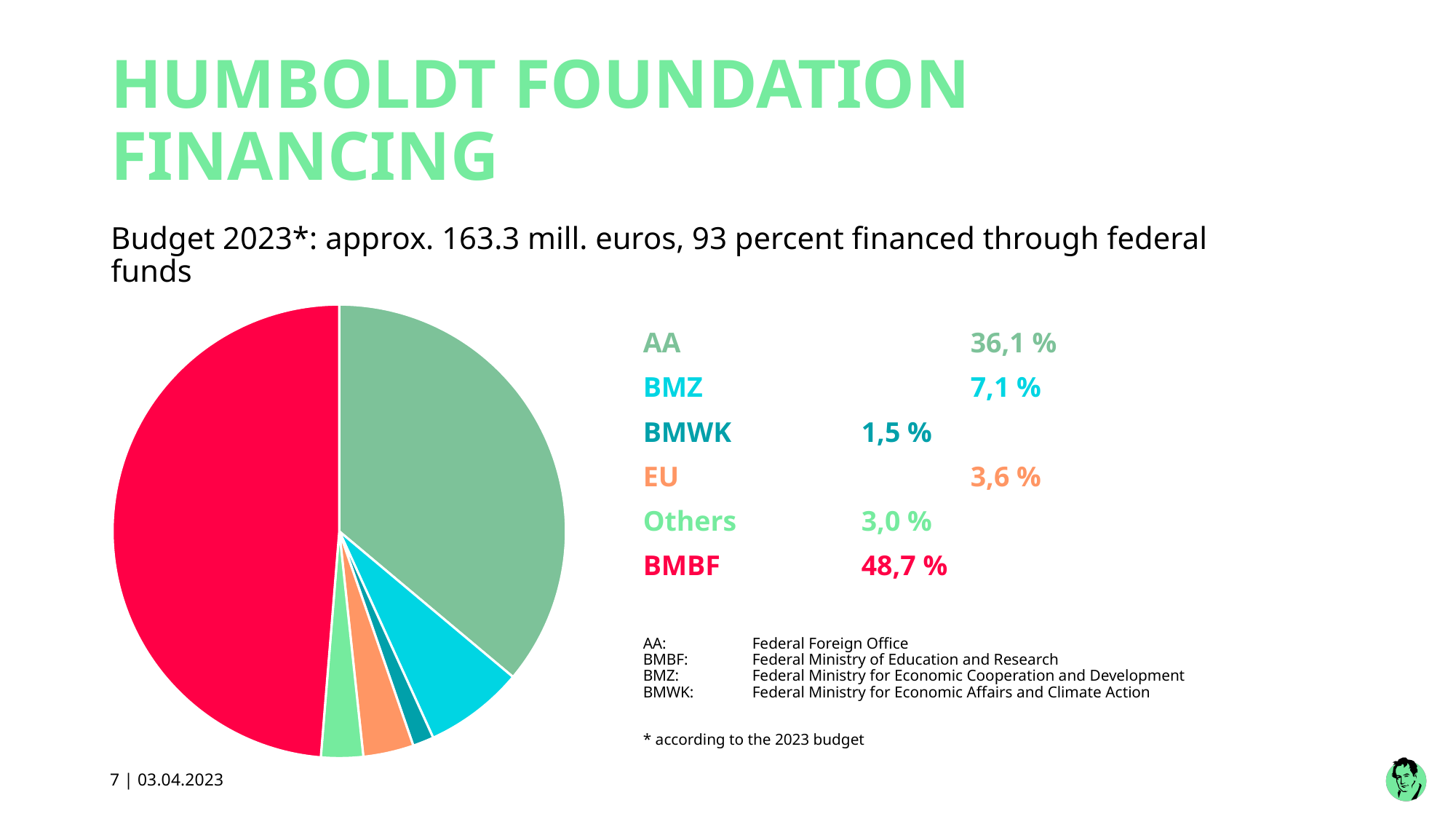
What is the difference in percentage points between the BMBF share and the AA share? 12,6 % Which is larger, the share for BMZ or the share for EU? BMZ Which source has the largest share of the financing? BMBF What share of the financing comes from BMWK? 1,5 % What does the abbreviation BMBF stand for according to the slide? Federal Ministry of Education and Research Which source has the smallest share of the financing? BMWK What share of the Humboldt Foundation financing comes from BMBF? 48,7 % What kind of chart is shown on the slide? pie chart What share of the financing comes from the EU? 3,6 % How many sources of financing are shown in the pie chart? 6 What share of the financing comes from AA? 36,1 % What share of the financing comes from BMZ? 7,1 %